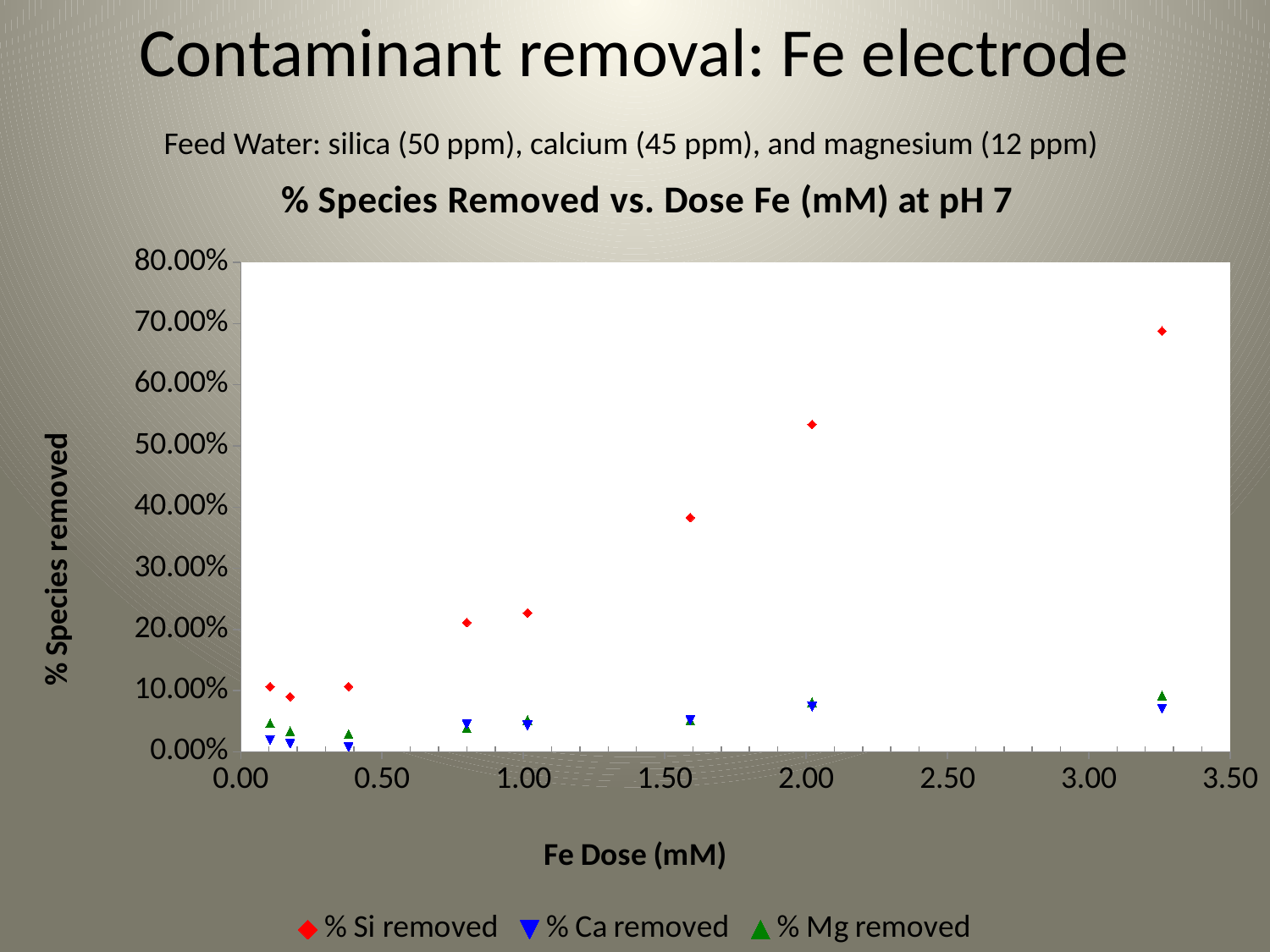
At the highest Fe dose, which is larger: % Si removed or % Ca removed? % Si removed How many series does the chart legend list? 3 What is the title of the chart? % Species Removed vs. Dose Fe (mM) at pH 7 Does % Si removed rise or fall as Fe dose increases along the x axis? rise What kind of chart is shown on the slide? scatter chart How many data points are plotted for the % Si removed series? 8 Is the % Ca removed at an Fe dose of about 3.25 mM greater or less than 10.00%? less What is the label of the x axis? Fe Dose (mM) Which series reaches the highest % removed on the chart? % Si removed Is the % Si removed at an Fe dose of about 2.00 mM greater or less than 40.00%? greater Is the % Si removed at the highest Fe dose (about 3.25 mM) greater or less than 60.00%? greater At an Fe dose of about 1.60 mM, which is larger: % Si removed or % Mg removed? % Si removed